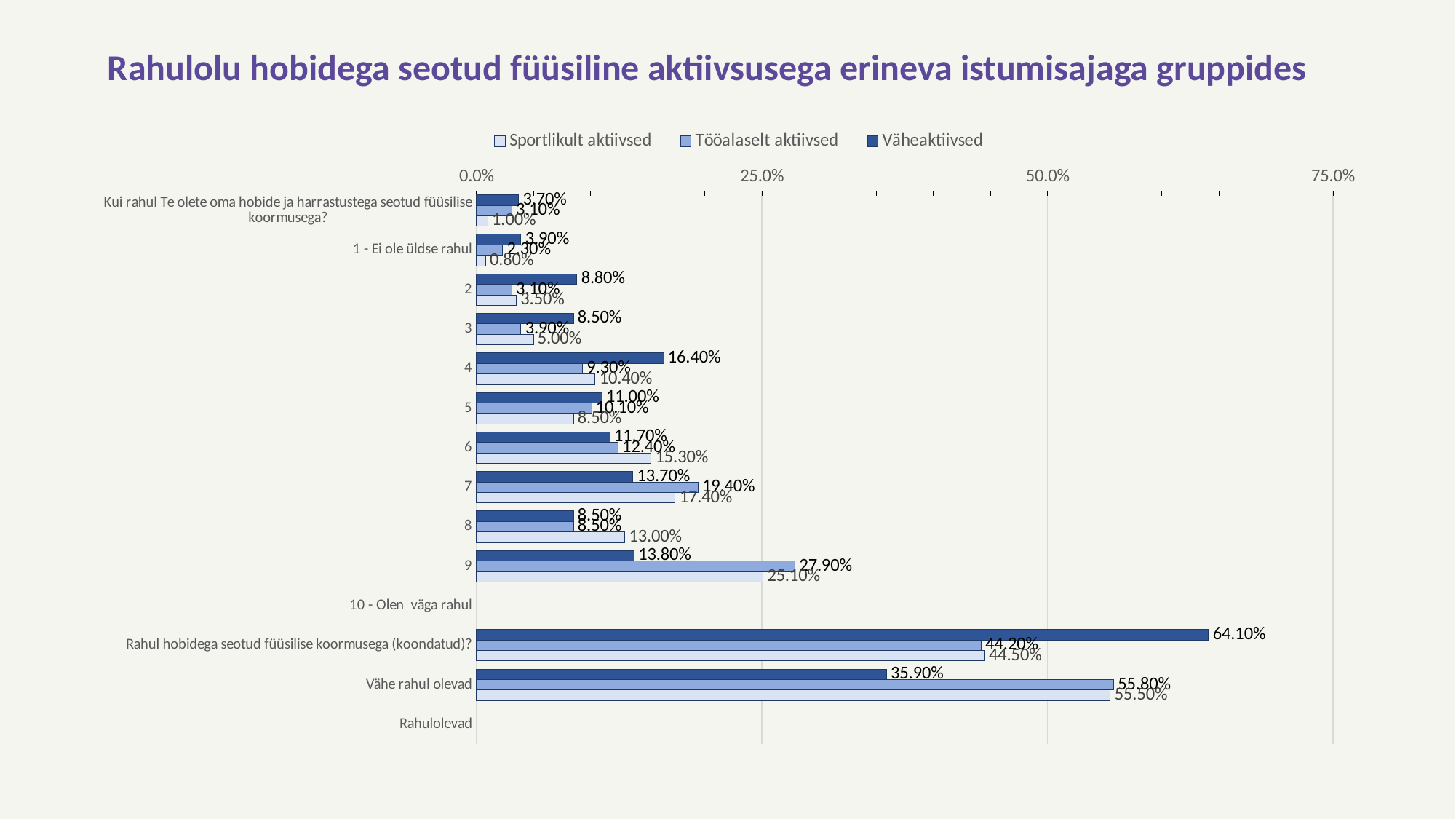
What is the value for Sportlikult aktiivsed in category 8? 13.00% What are the three series named in the legend? Sportlikult aktiivsed, Tööalaselt aktiivsed, Väheaktiivsed How many series does the legend list? 3 In category 9, how much larger is the Tööalaselt aktiivsed value than the Väheaktiivsed value? 14.10% What type of chart is shown on the slide? bar chart What is the value for Väheaktiivsed in category 4? 16.40% Is the Väheaktiivsed value for 'Rahul hobidega seotud füüsilise koormusega (koondatud)?' greater or less than 50.0%? greater In category 4, what is the difference between the Väheaktiivsed value and the Tööalaselt aktiivsed value? 7.10% What is the value for Sportlikult aktiivsed in category 7? 17.40% In category 6, which series has the larger value: Sportlikult aktiivsed or Väheaktiivsed? Sportlikult aktiivsed What is the largest value labelled anywhere on the chart? 64.10% What is the value for Tööalaselt aktiivsed in category 9? 27.90%